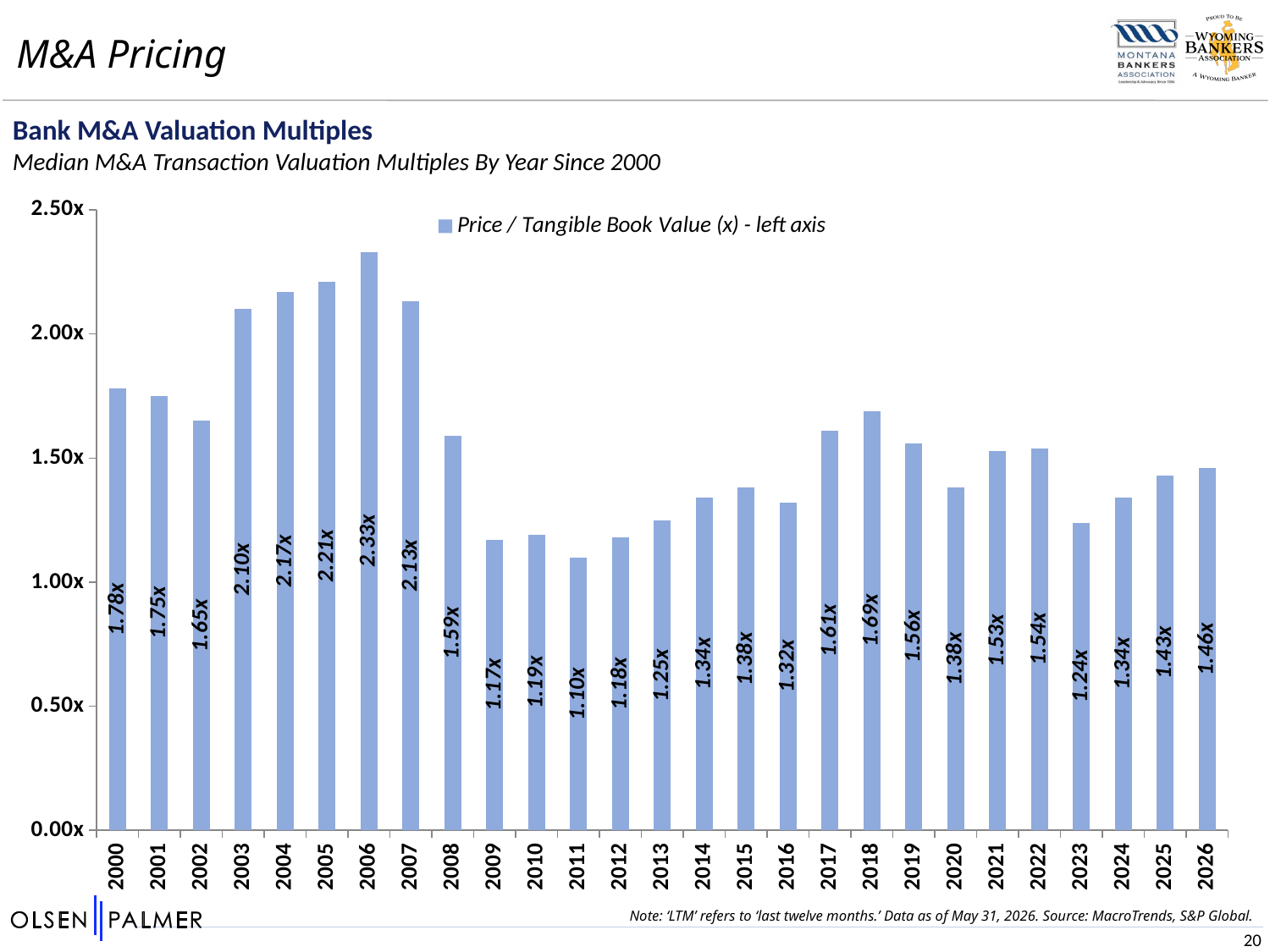
Which year has the larger Price / Tangible Book Value multiple, 2017 or 2019? 2017 Which year has the lowest Price / Tangible Book Value multiple? 2011 What is the Price / Tangible Book Value multiple for 2026? 1.46x What kind of chart is shown on the slide? Bar chart What is the difference between the 2006 and 2011 Price / Tangible Book Value multiples? 1.23x What is the Price / Tangible Book Value multiple for 2006? 2.33x Do the Price / Tangible Book Value multiples rise or fall from 2003 to 2006? Rise Is the Price / Tangible Book Value multiple for 2008 greater or less than 1.50x? greater Which year has the highest Price / Tangible Book Value multiple? 2006 What is the difference between the 2018 and 2023 Price / Tangible Book Value multiples? 0.45x How many series does the chart legend list? 1 How many years are shown on the x axis of the chart? 27